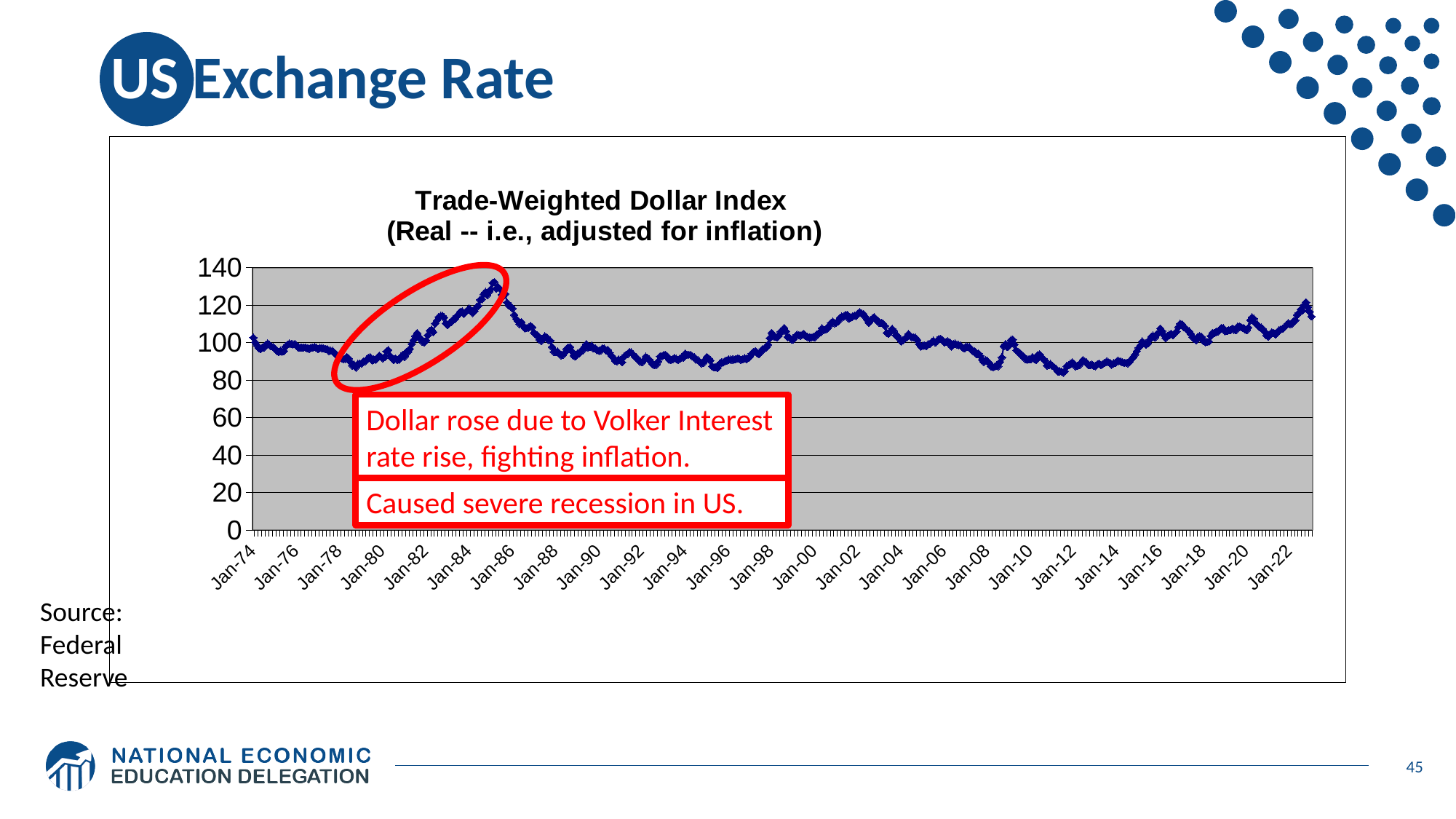
Is the value of the Trade-Weighted Dollar Index at Jan-74 greater or less than 80? greater What is the highest value shown on the vertical axis of the chart? 140 Around which year does the Trade-Weighted Dollar Index reach its highest point? 1985 Is the value of the Trade-Weighted Dollar Index around Jan-12 greater or less than 100? less Which is higher, the Trade-Weighted Dollar Index around Jan-85 or around Jan-12? Jan-85 Did the Trade-Weighted Dollar Index rise or fall between Jan-80 and Jan-85? rise Is the value of the Trade-Weighted Dollar Index around Jan-96 greater or less than 100? less Did the Trade-Weighted Dollar Index rise or fall between Jan-86 and Jan-88? fall What kind of chart is shown on the slide? line chart What is the title of the chart? Trade-Weighted Dollar Index (Real -- i.e., adjusted for inflation)